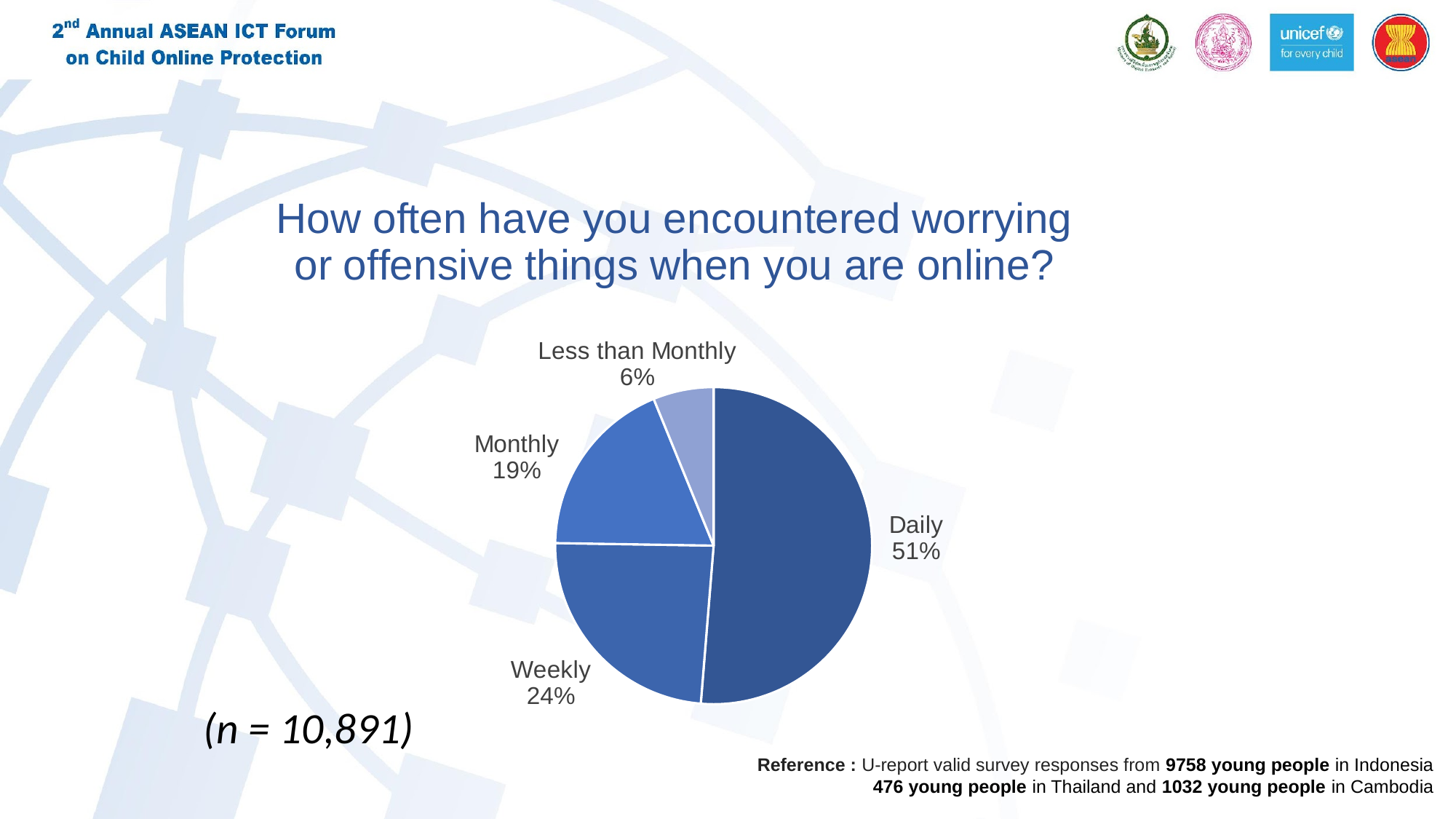
What percentage of respondents answered Less than Monthly? 6% Which is larger, the share for Weekly or the share for Monthly? Weekly What percentage of respondents answered Daily? 51% What is the combined share of Monthly and Less than Monthly? 25% What percentage of respondents answered Monthly? 19% How many categories are shown in the pie chart? 4 Which response category has the largest share of the pie? Daily What type of chart is shown on the slide? pie chart What percentage of respondents answered Weekly? 24% What is the difference in percentage points between Daily and Weekly? 27 What is the sample size (n) stated on the slide for the chart? 10,891 Which response category has the smallest share of the pie? Less than Monthly